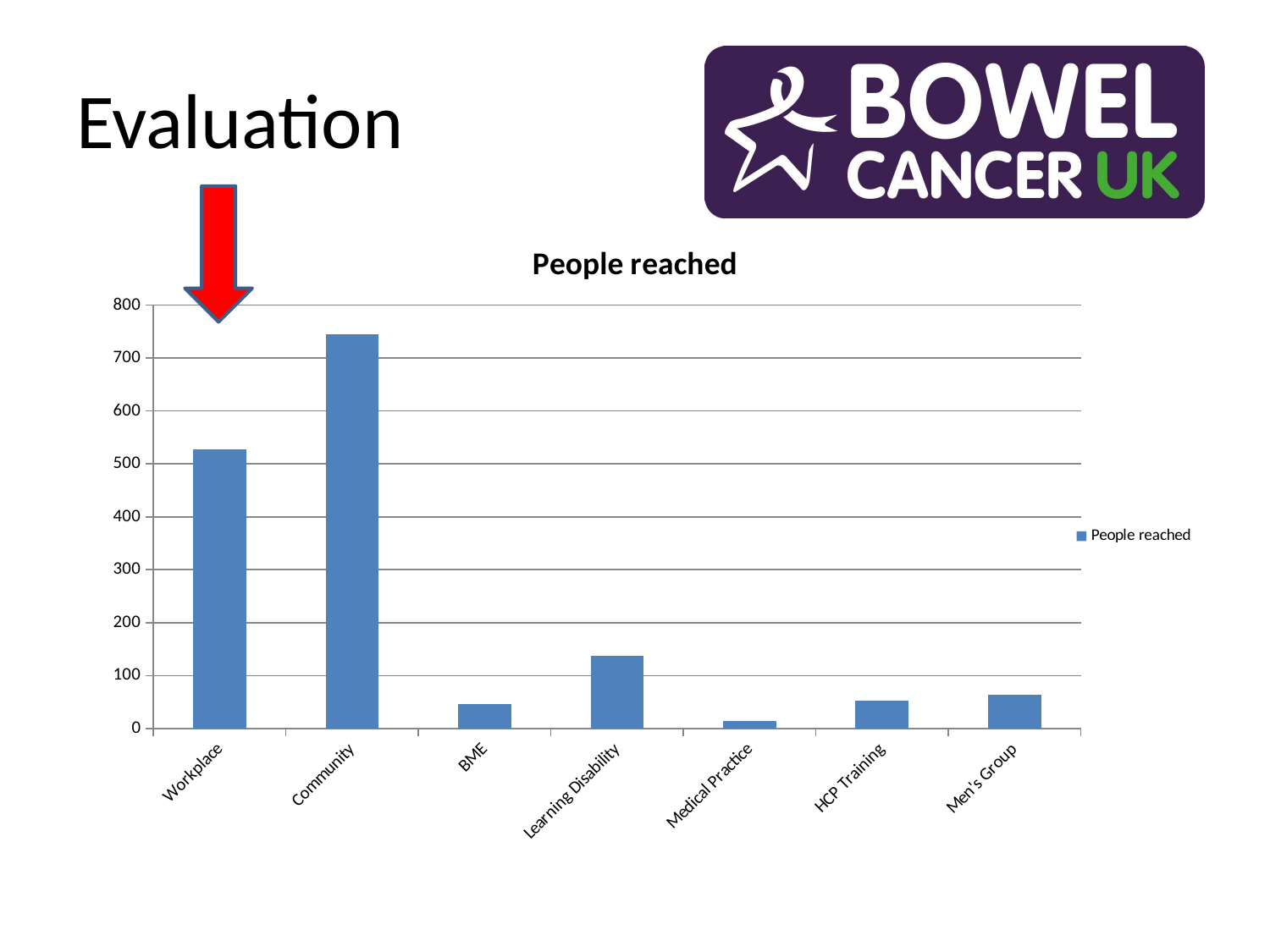
What kind of chart is shown under the title "People reached"? bar chart How many categories are shown on the x axis of the "People reached" chart? 7 Which is larger, the value for Workplace or the value for Community? Community Is the value for Learning Disability greater or less than 100? greater Which is larger, the value for Learning Disability or the value for BME? Learning Disability Is the value for Community greater or less than 700? greater Which category has the lowest value in the "People reached" chart? Medical Practice What is the title of the chart on the slide? People reached Is the value for Workplace greater or less than 500? greater Which category has the highest value in the "People reached" chart? Community How many series does the legend of the "People reached" chart list? 1